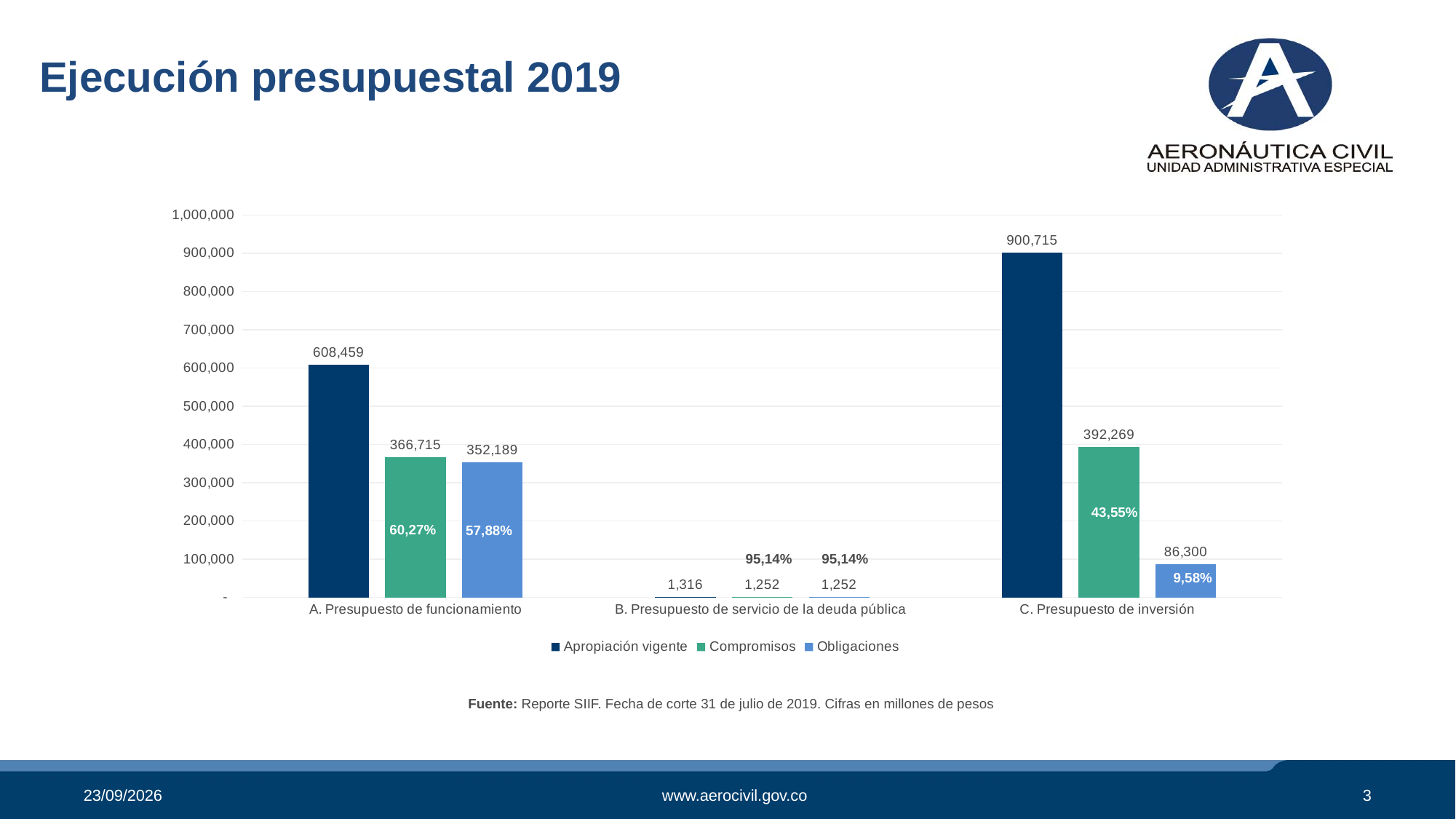
How many series does the legend list? 3 Which is larger: the Compromisos value for A. Presupuesto de funcionamiento or for C. Presupuesto de inversión? C. Presupuesto de inversión What is the difference between the Apropiación vigente and Compromisos values for A. Presupuesto de funcionamiento? 241,744 What is the Obligaciones value for C. Presupuesto de inversión? 86,300 Which category has the highest Apropiación vigente value? C. Presupuesto de inversión What is the Compromisos value for A. Presupuesto de funcionamiento? 366,715 What is the Apropiación vigente value for B. Presupuesto de servicio de la deuda pública? 1,316 Which category has the lowest Compromisos value? B. Presupuesto de servicio de la deuda pública How many categories are shown on the x axis? 3 What kind of chart is shown on the slide? Bar chart Is the Obligaciones value for A. Presupuesto de funcionamiento greater or less than 300,000? greater What is the Apropiación vigente value for C. Presupuesto de inversión? 900,715